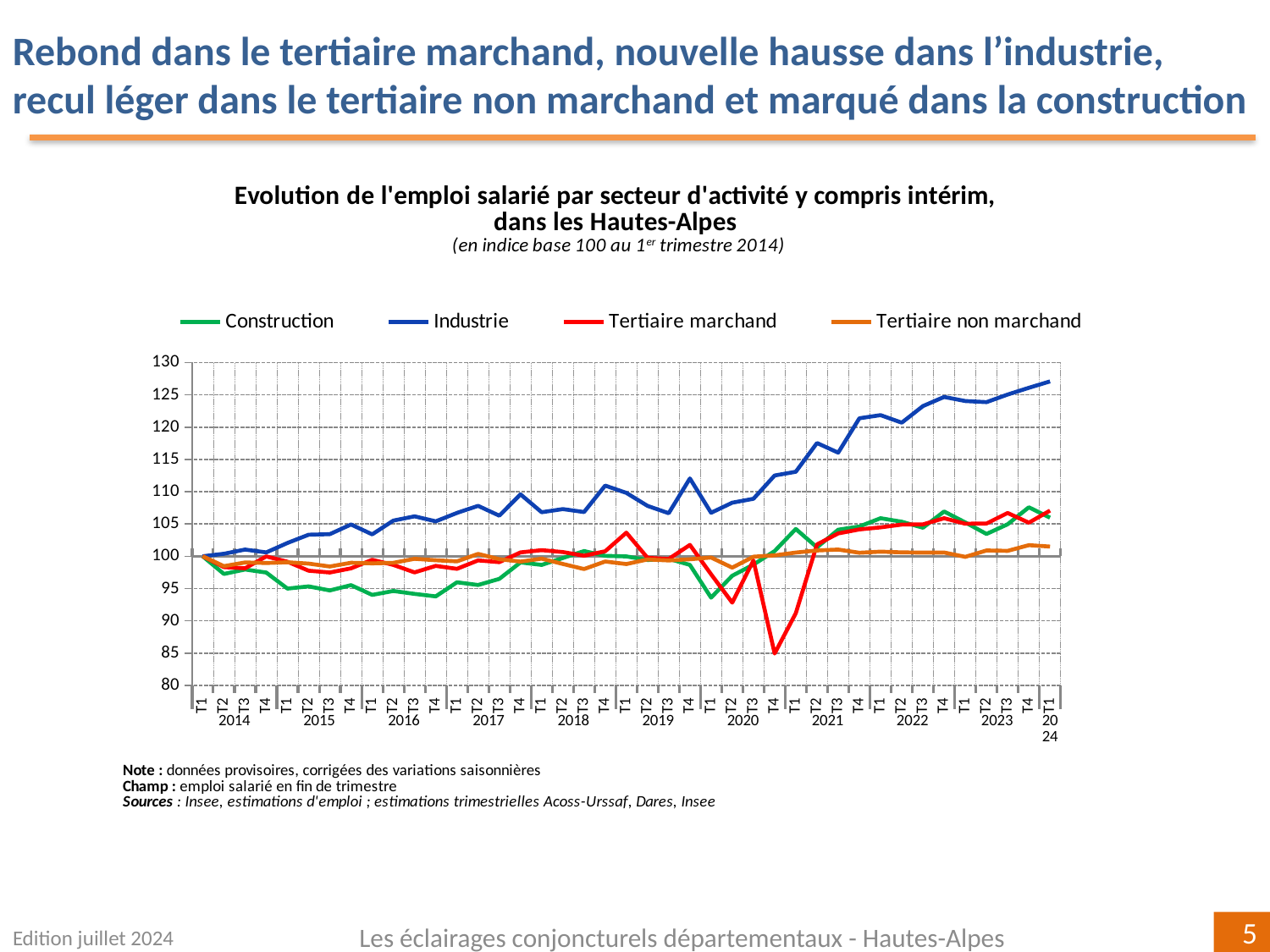
Is the value for Industrie at T1 2021 greater or less than 110? greater Is the value for Industrie at T1 2024 greater or less than 125? greater Which series has the lowest value at T4 2020? Tertiaire marchand How many series does the legend list? 4 Is the value for Construction at T1 2020 greater or less than 100? less What is the index value of all series at T1 2014, the base quarter? 100 Does the Industrie series rise or fall overall from T1 2014 to T1 2024? rise What kind of chart is shown on the slide? line chart At T1 2024, which is larger: the value for Industrie or the value for Construction? Industrie Which series has the highest value at T1 2024? Industrie Which colour is used for the Industrie series? blue